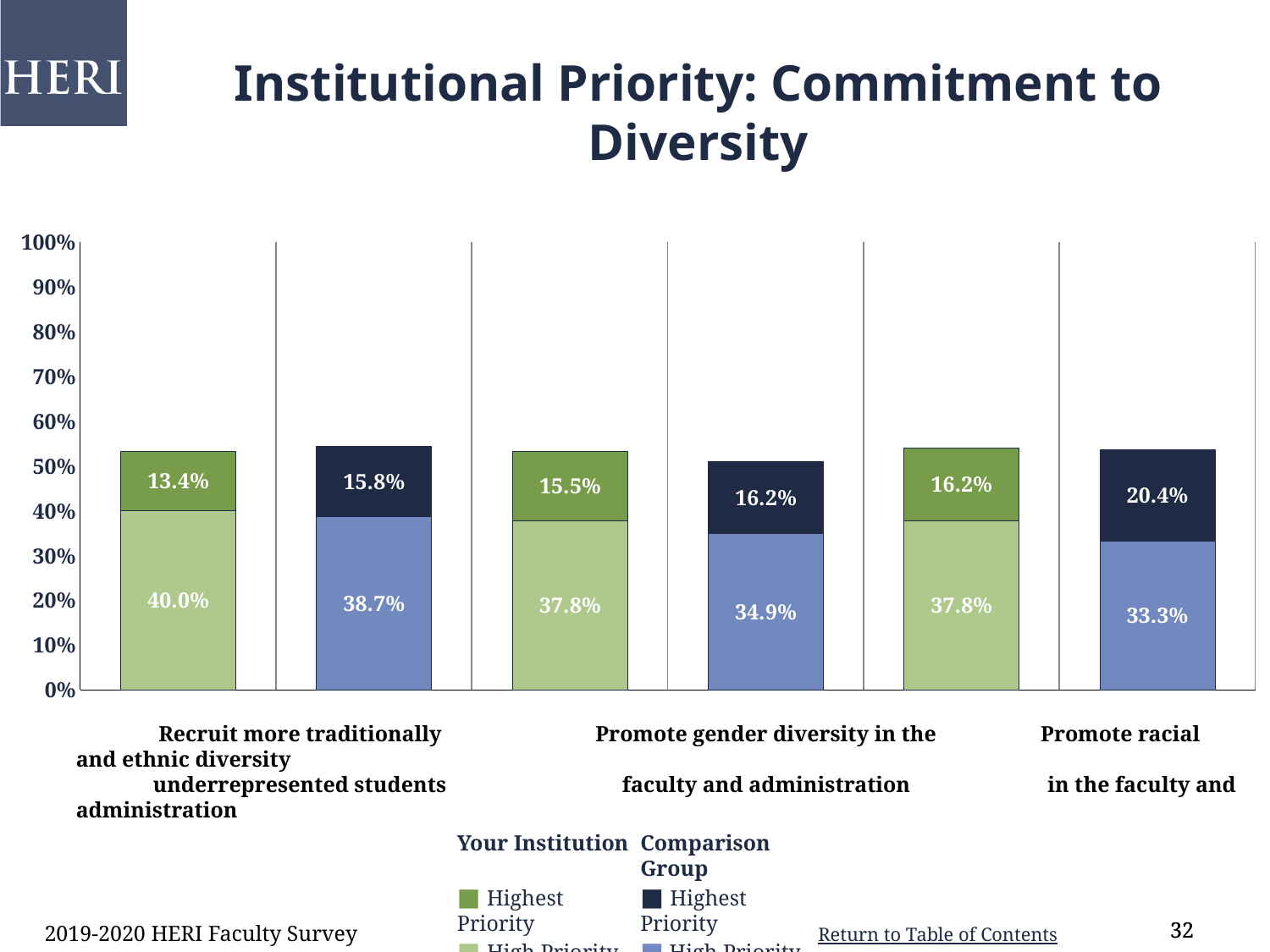
What is the combined High Priority and Highest Priority percentage for Your Institution on recruiting more traditionally underrepresented students? 53.4% What is the combined High Priority and Highest Priority percentage for the Comparison Group on promoting gender diversity in the faculty and administration? 51.1% What is the High Priority percentage for the Comparison Group on promoting gender diversity in the faculty and administration? 34.9% What percentage of Your Institution faculty rated recruiting more traditionally underrepresented students as a High Priority? 40.0% What type of chart is shown on the slide? Stacked bar chart What is the difference between the Comparison Group's and Your Institution's Highest Priority percentages for promoting racial and ethnic diversity in the faculty and administration? 4.2% Which item has the lowest High Priority percentage for the Comparison Group? Promote racial and ethnic diversity in the faculty and administration How many institutional priority items are shown on the chart? 3 For recruiting more traditionally underrepresented students, which is larger: Your Institution's High Priority percentage or the Comparison Group's High Priority percentage? Your Institution Which item has the largest Highest Priority percentage for the Comparison Group? Promote racial and ethnic diversity in the faculty and administration What is the Highest Priority percentage for Your Institution on promoting gender diversity in the faculty and administration? 15.5% What percentage of the Comparison Group rated promoting racial and ethnic diversity in the faculty and administration as the Highest Priority? 20.4%